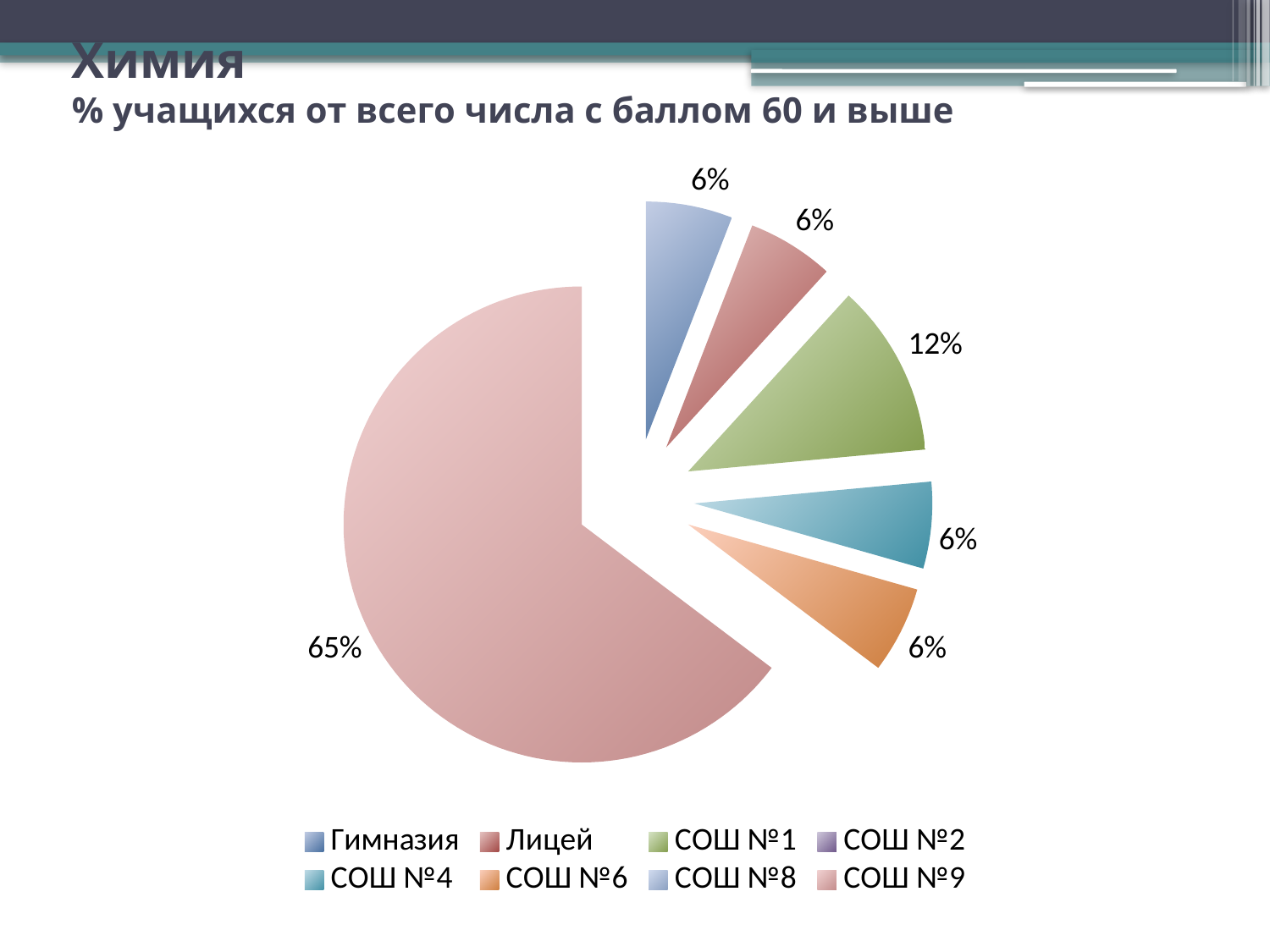
What is the value shown for СОШ №1? 12% What share of the pie does СОШ №9 have? 65% What is the value shown for Лицей? 6% How many entries does the legend list? 8 Which school has the largest slice of the pie? СОШ №9 What is the value shown for Гимназия? 6% What is the value shown for СОШ №4? 6% By how many percentage points does СОШ №9 exceed СОШ №1? 53 What is the subject named in the slide title? Химия What is the value shown for СОШ №6? 6% What kind of chart is shown on the slide? Pie chart Which is larger, the slice for СОШ №1 or the slice for Гимназия? СОШ №1